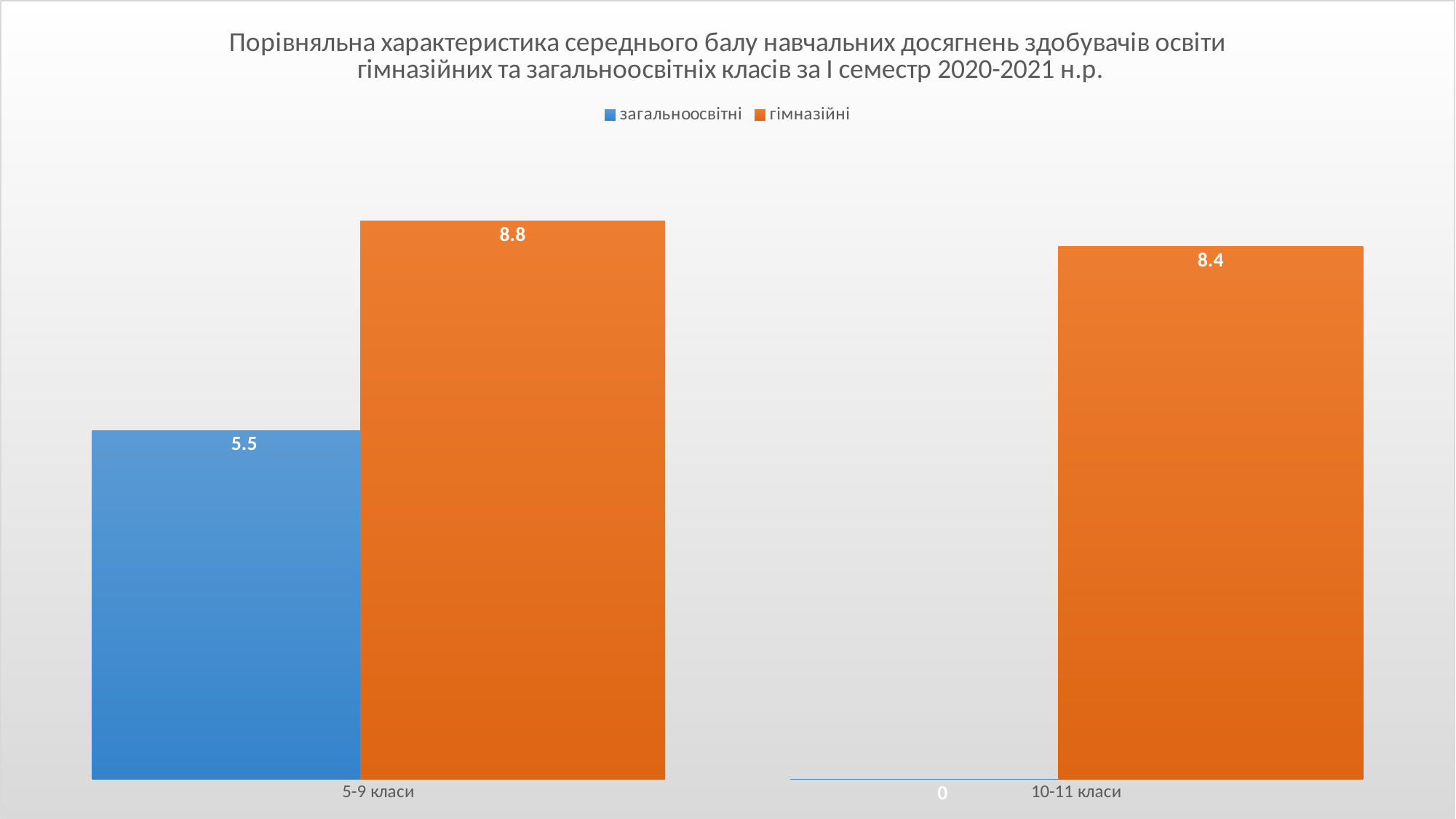
How many series does the legend list? 2 Which category has the highest value for гімназійні? 5-9 класи Which colour represents the гімназійні series? orange What is the value for загальноосвітні in the 5-9 класи category? 5.5 What is the difference between the гімназійні values for 5-9 класи and 10-11 класи? 0.4 What is the value for гімназійні in the 5-9 класи category? 8.8 What is the value for гімназійні in the 10-11 класи category? 8.4 What is the difference between the гімназійні and загальноосвітні values in the 5-9 класи category? 3.3 How many categories are shown on the x axis? 2 What is the value for загальноосвітні in the 10-11 класи category? 0 Which is larger in the 5-9 класи category: загальноосвітні or гімназійні? гімназійні What kind of chart is shown on the slide? bar chart